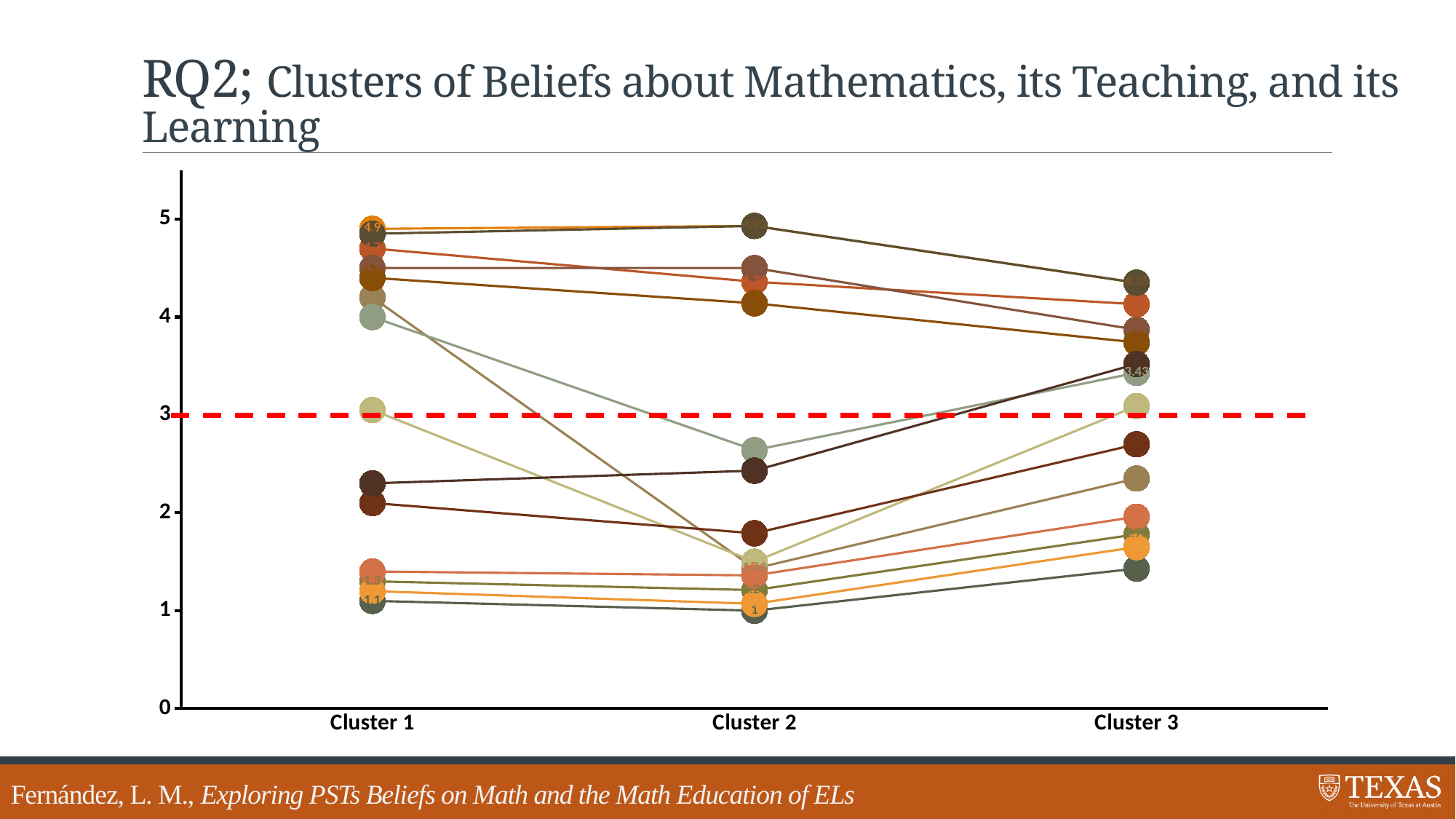
How many clusters are shown along the x axis? 3 Which cluster has the lowest single plotted point on the chart? Cluster 2 What kind of chart is shown on the slide? line chart Is the highest point at Cluster 2 greater or less than 4? greater What are the category labels on the x axis? Cluster 1, Cluster 2, Cluster 3 Is the lowest point at Cluster 2 greater or less than 2? less Is the highest point at Cluster 3 greater or less than 4? greater At what value on the y axis is the red dashed horizontal line drawn? 3